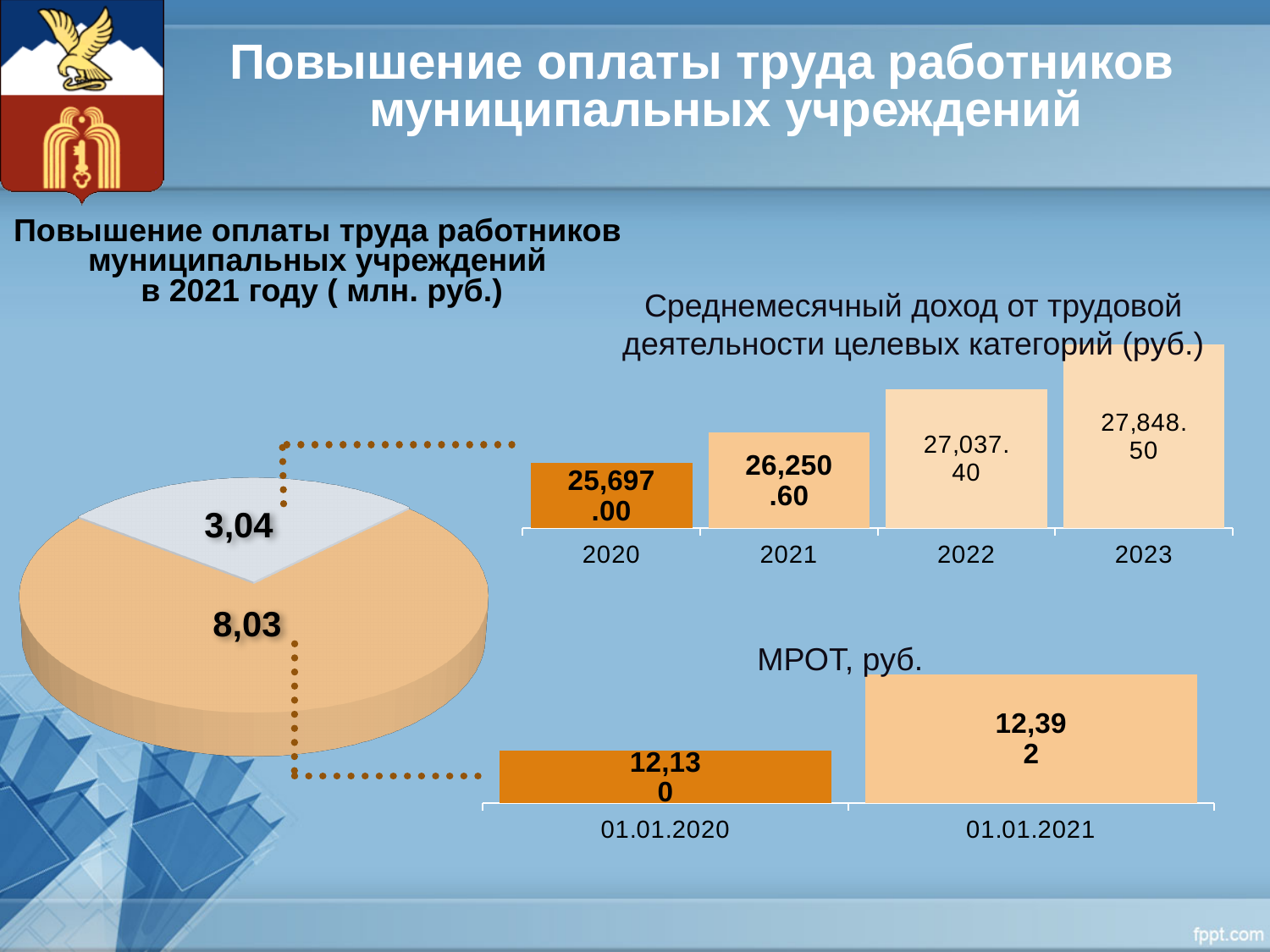
How many years are shown in the chart 'Среднемесячный доход от трудовой деятельности целевых категорий (руб.)'? 4 In the chart 'Среднемесячный доход от трудовой деятельности целевых категорий (руб.)', what is the value for 2023? 27,848.50 In the chart 'Среднемесячный доход от трудовой деятельности целевых категорий (руб.)', what is the value for 2020? 25,697.00 In the chart 'МРОТ, руб.', which is larger, the value for 01.01.2020 or 01.01.2021? 01.01.2021 In the chart 'Среднемесячный доход от трудовой деятельности целевых категорий (руб.)', do the values rise or fall from 2020 to 2023? rise In the chart 'МРОТ, руб.', what is the value for 01.01.2021? 12,392 In the pie chart on the left of the slide, what is the total of the two slice values shown? 11,07 In the chart 'Среднемесячный доход от трудовой деятельности целевых категорий (руб.)', which year has the highest value? 2023 In the chart 'Среднемесячный доход от трудовой деятельности целевых категорий (руб.)', which year has the lowest value? 2020 In the chart 'Среднемесячный доход от трудовой деятельности целевых категорий (руб.)', what is the difference between the 2023 and 2020 values? 2,151.50 In the chart 'МРОТ, руб.', what is the difference between the 01.01.2021 and 01.01.2020 values? 262 What kind of chart is the one on the left of the slide titled 'Повышение оплаты труда работников муниципальных учреждений в 2021 году ( млн. руб.)'? pie chart